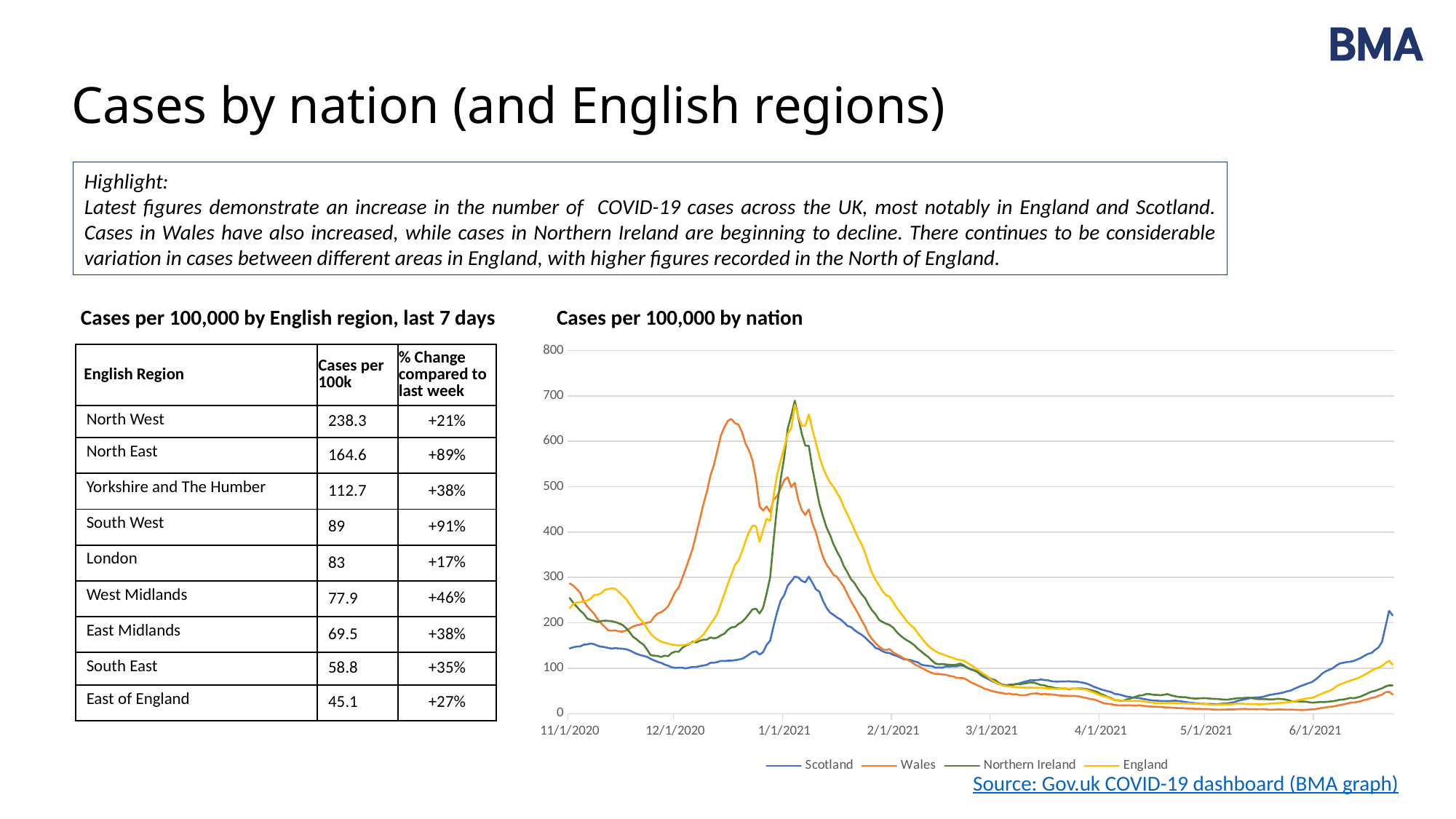
How many date labels are shown on the x axis of the 'Cases per 100,000 by nation' chart? 8 In the 'Cases per 100,000 by nation' chart, is the peak value for Northern Ireland in January 2021 greater or less than 600? greater In the 'Cases per 100,000 by nation' chart, do the values for England rise or fall between 1/1/2021 and 3/1/2021? fall How many series does the legend of the 'Cases per 100,000 by nation' chart list? 4 In the 'Cases per 100,000 by nation' chart, which nation has the highest value at the right-hand end of the chart (June 2021)? Scotland In the 'Cases per 100,000 by nation' chart, at the right-hand end of the chart, is the value for Scotland or England larger? Scotland In the 'Cases per 100,000 by nation' chart, is the peak value for Scotland around 1/1/2021 greater or less than 400? less What is the title of the line chart on the right of the slide? Cases per 100,000 by nation Which nations are listed in the legend of the 'Cases per 100,000 by nation' chart? Scotland, Wales, Northern Ireland, England What kind of chart is 'Cases per 100,000 by nation'? line chart In the 'Cases per 100,000 by nation' chart, is the value for Wales at 5/1/2021 greater or less than 100? less